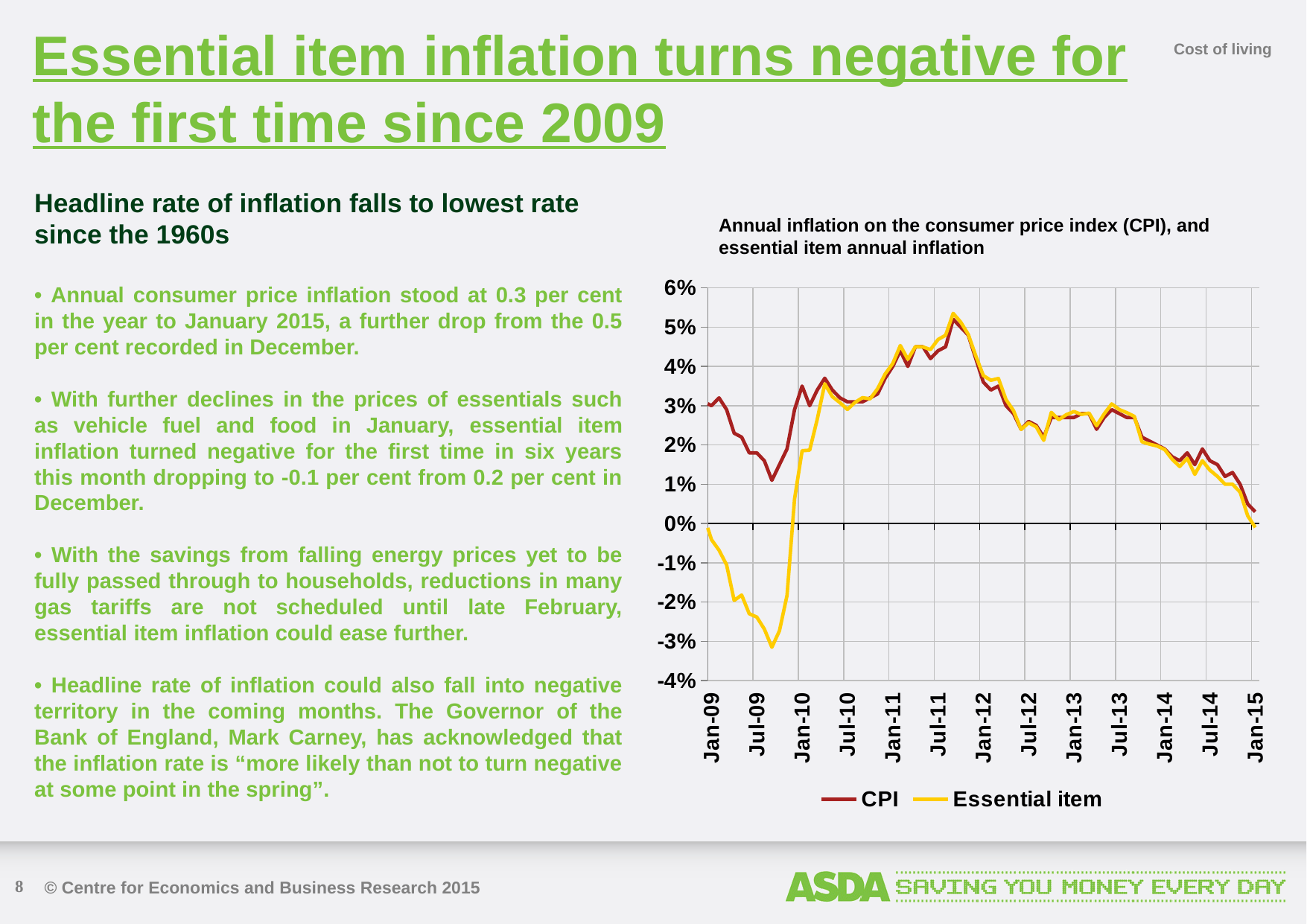
What are the two series named in the chart legend? CPI and Essential item Is the Essential item value at Jul-09 greater or less than -1%? less Which series is drawn in yellow on the chart? Essential item In which year does the CPI series reach its highest value? 2011 How many series does the chart legend list? 2 Is the CPI value at Jan-15 greater or less than 1%? less In which year does the Essential item series reach its lowest value? 2009 At Jul-09, which series has the higher value, CPI or Essential item? CPI Is the CPI value at Jan-09 greater or less than 2%? greater Between Jan-12 and Jan-15, does the CPI series generally rise or fall? fall What kind of chart is shown on the slide? Line chart